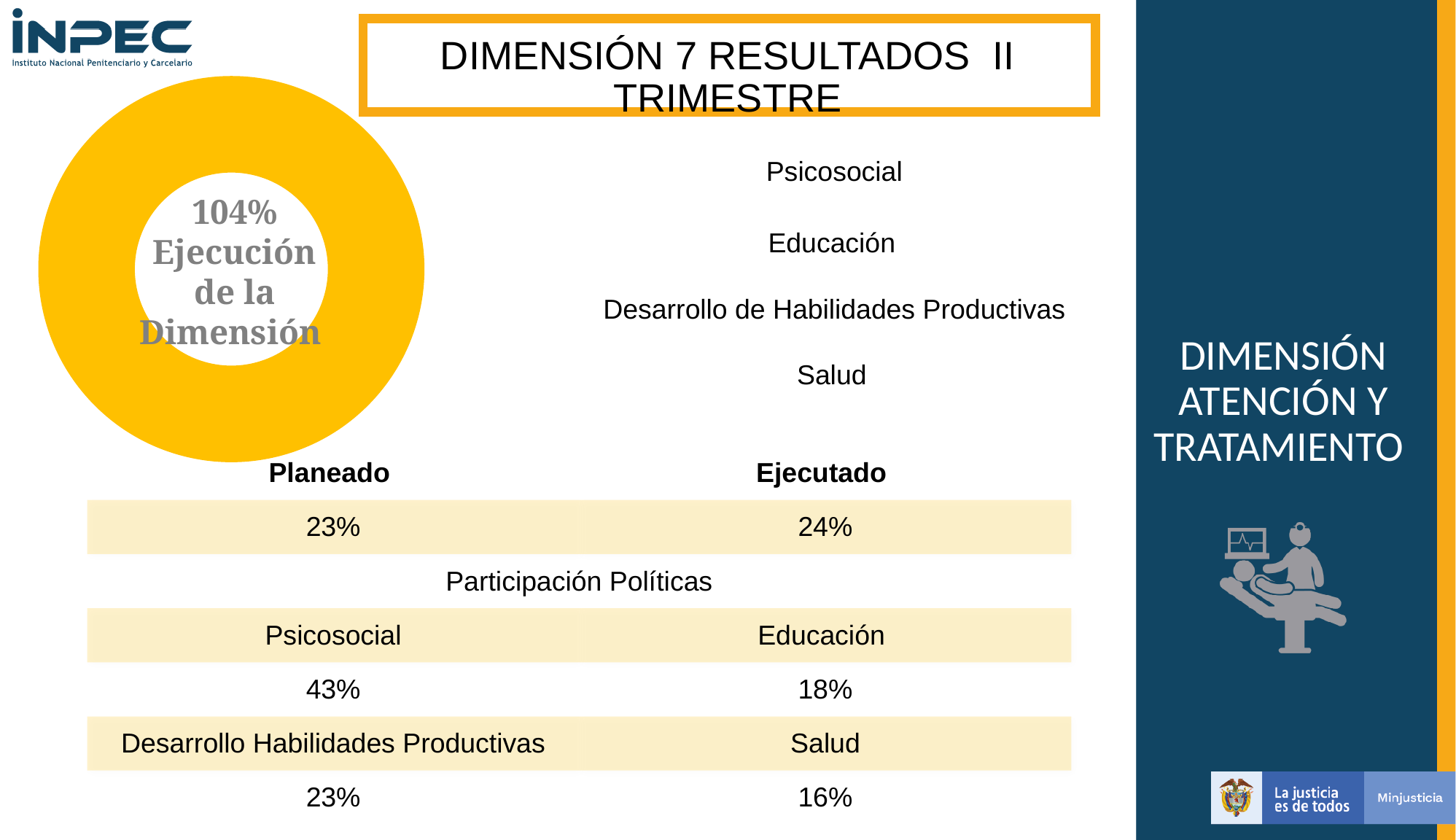
What colour is the ring of the doughnut chart? Yellow What does the text in the centre of the doughnut chart say the 104% represents? Ejecución de la Dimensión What percentage is printed in the centre of the doughnut chart? 104% What kind of chart is shown on the left of the slide? Doughnut chart Is the execution value shown in the doughnut chart greater or less than 100%? greater